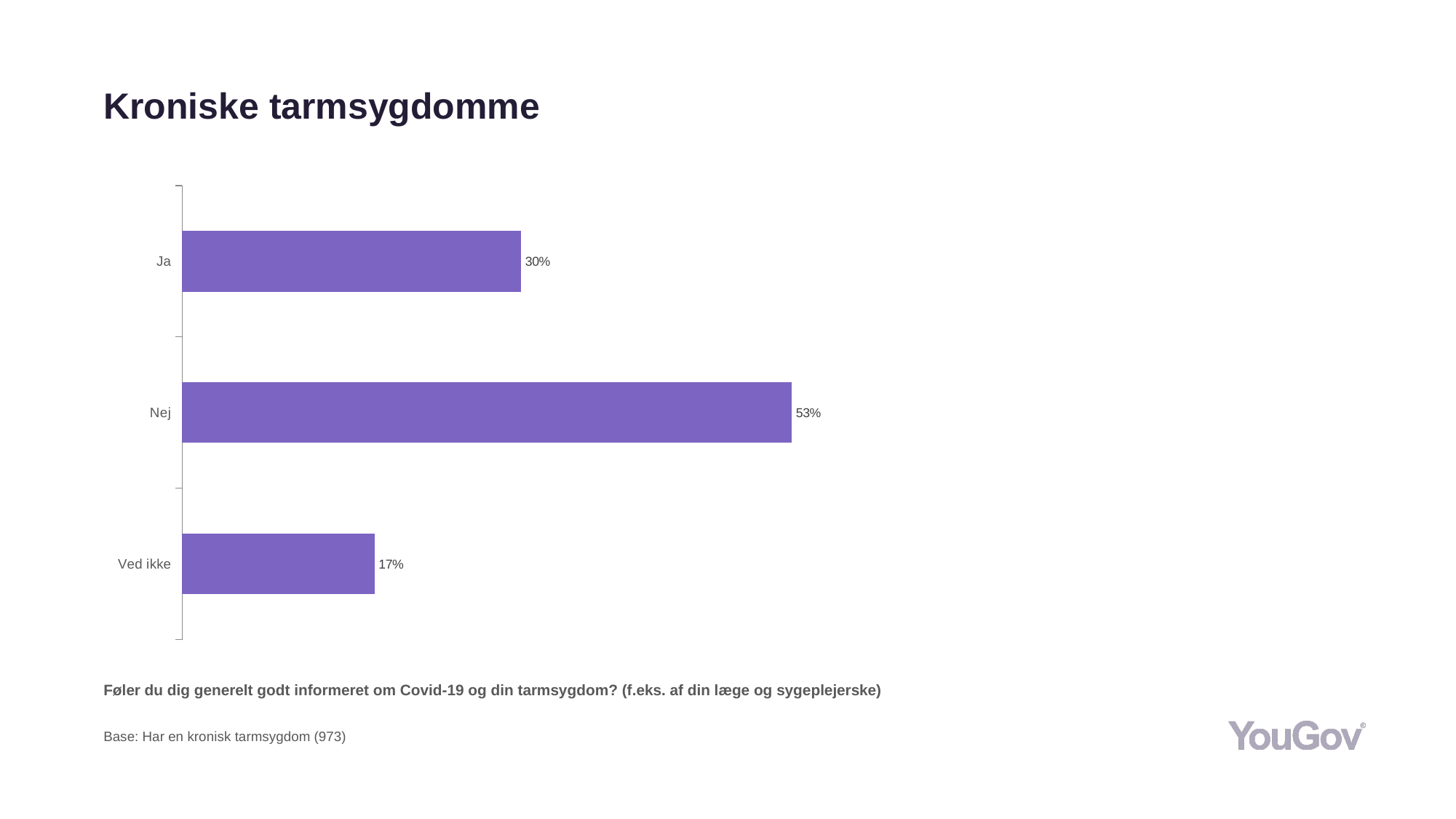
How many categories are shown in the chart? 3 What is the title of the slide? Kroniske tarmsygdomme What is the value for "Nej"? 53% What is the value for "Ved ikke"? 17% Which category has the lowest value? Ved ikke What is the difference between the values for "Ja" and "Ved ikke"? 13 percentage points Which is larger, the value for "Ja" or the value for "Ved ikke"? Ja What is the difference between the values for "Nej" and "Ja"? 23 percentage points What is the base size stated below the chart? 973 What kind of chart is shown on the slide? Bar chart What is the value for "Ja"? 30% Which category has the highest value? Nej